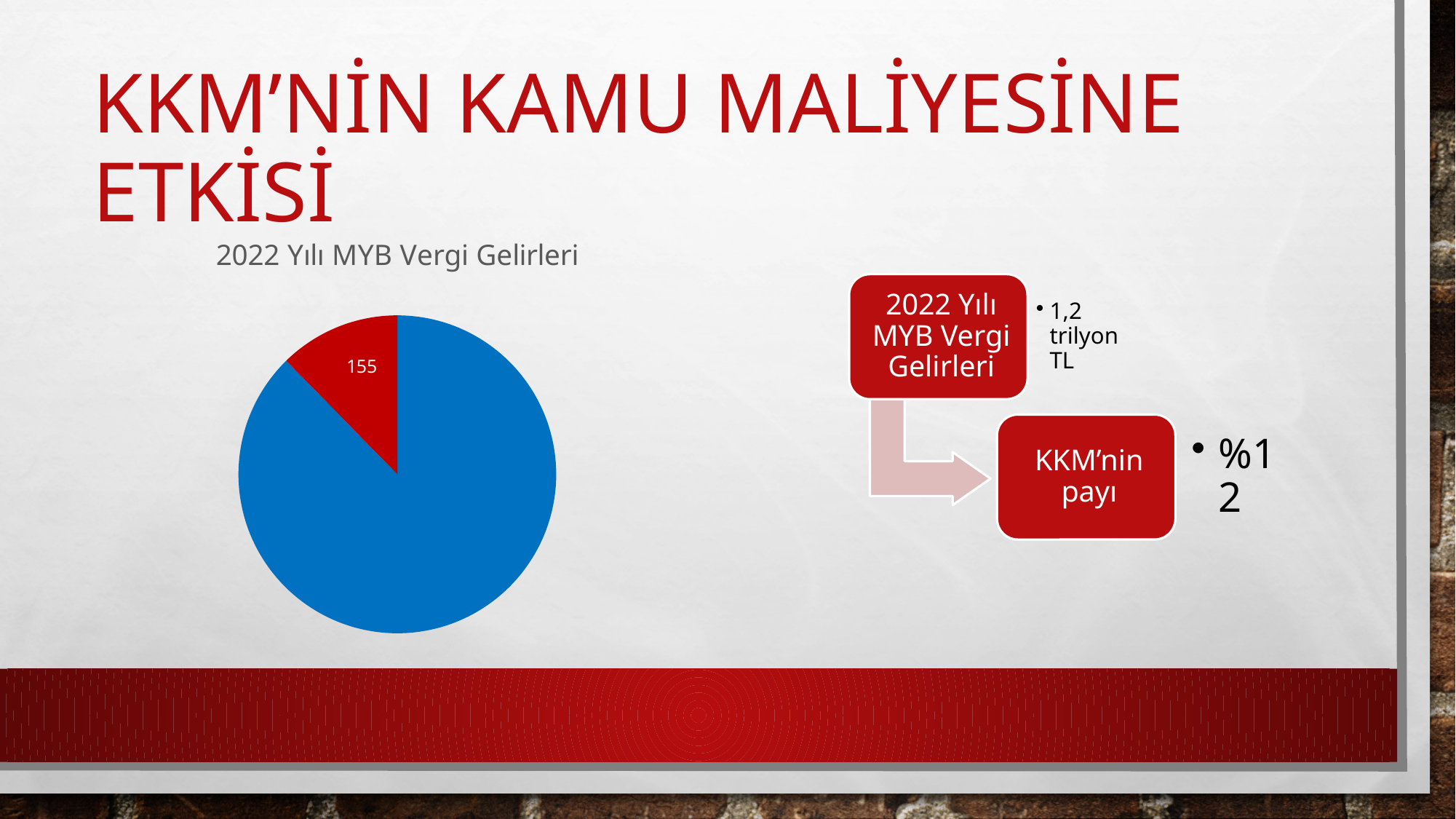
What is the title of the pie chart? 2022 Yılı MYB Vergi Gelirleri What colour is the slice labelled 155 in the pie chart? red Which colour slice is the smallest in the pie chart? red Which slice of the pie chart is larger, the blue one or the red one? the blue one What kind of chart is shown on the slide? pie chart What value is printed on the red slice of the pie chart? 155 How many slices does the pie chart have? 2 Which colour slice is the largest in the pie chart? blue